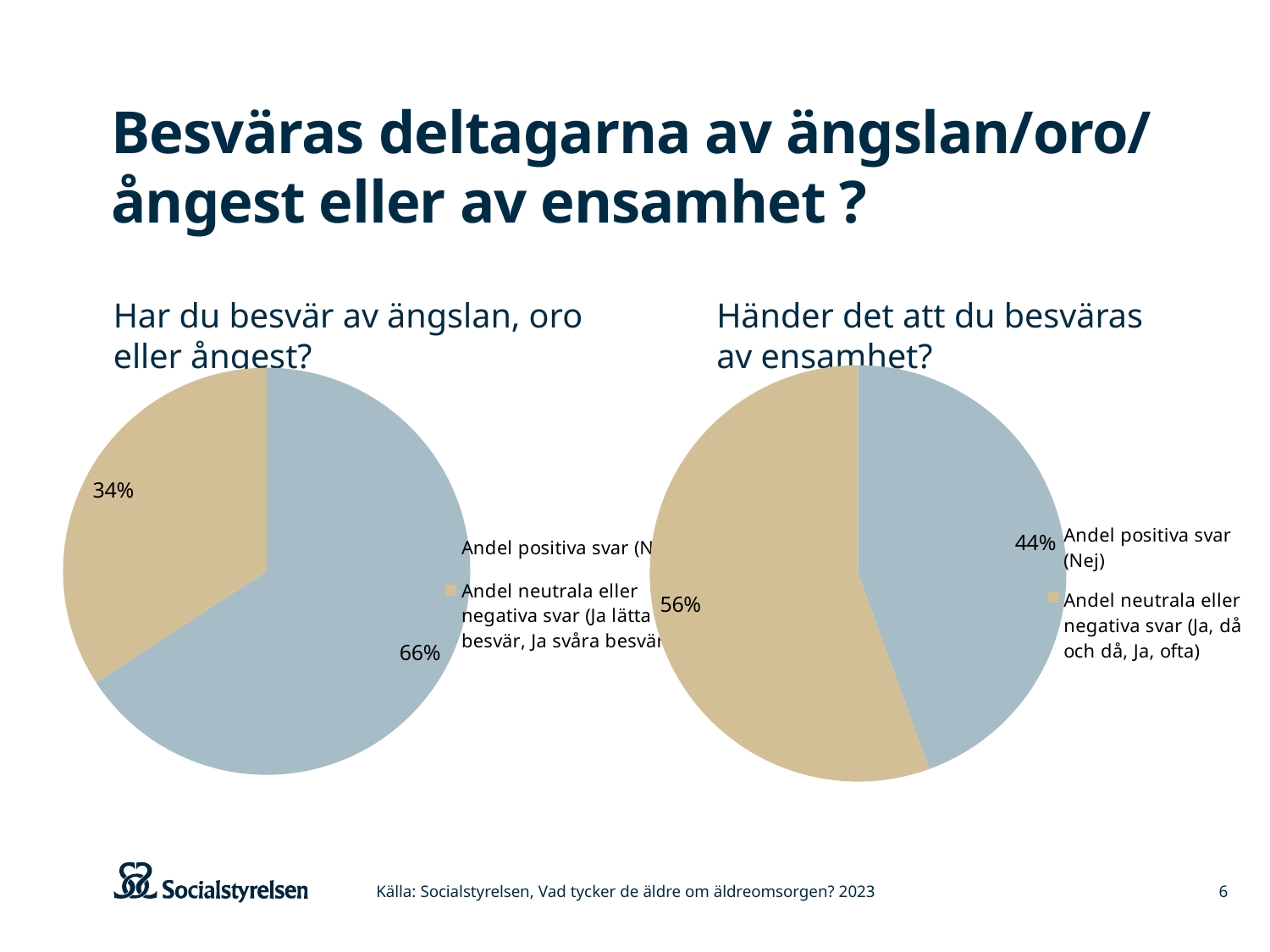
In the left chart 'Har du besvär av ängslan, oro eller ångest?', what share of answers are positive (Nej)? 66% What type of chart is used on this slide? Pie chart In the right chart 'Händer det att du besväras av ensamhet?', which slice is the smallest? Andel positiva svar (Nej) Which chart has the larger share of positive answers (Nej): the left chart about ängslan/oro/ångest or the right chart about ensamhet? The left chart (ängslan, oro eller ångest) In the left chart 'Har du besvär av ängslan, oro eller ångest?', which slice is the largest? Andel positiva svar (Nej) In the right chart 'Händer det att du besväras av ensamhet?', what share of answers are positive (Nej)? 44% How many entries does the legend of the right chart 'Händer det att du besväras av ensamhet?' list? 2 How many slices does the right chart 'Händer det att du besväras av ensamhet?' have? 2 In the left chart 'Har du besvär av ängslan, oro eller ångest?', what is the difference in percentage points between the positive and the neutral/negative share? 32 percentage points In the right chart 'Händer det att du besväras av ensamhet?', what share of answers are neutral or negative? 56% In the left chart 'Har du besvär av ängslan, oro eller ångest?', what share of answers are neutral or negative? 34% In the right chart 'Händer det att du besväras av ensamhet?', what is the difference in percentage points between the neutral/negative and the positive share? 12 percentage points